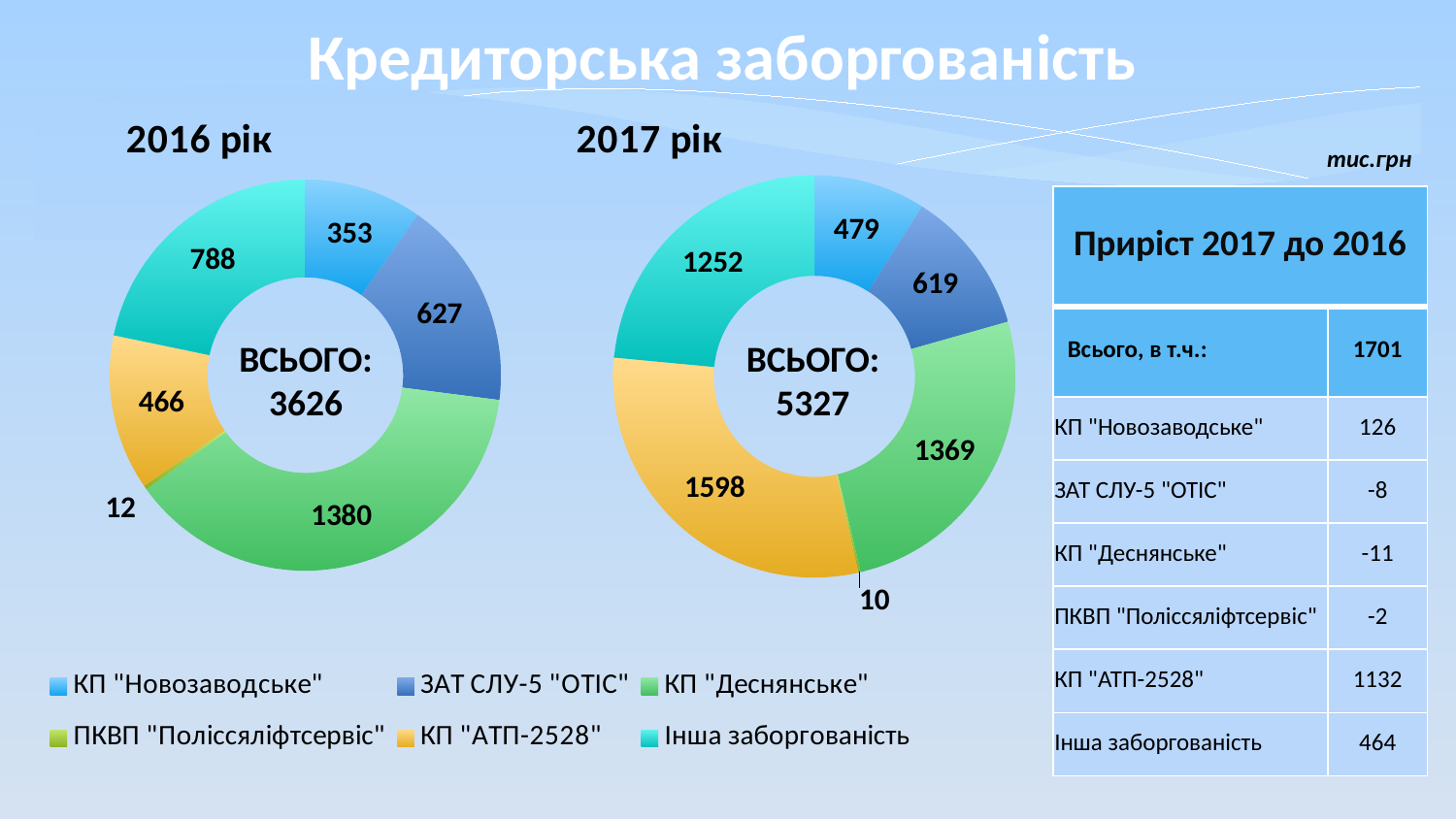
In the 2017 рік chart, what is the value for Інша заборгованість? 1252 How many categories does the legend list for the charts? 6 In the 2017 рік chart, which is larger: КП "АТП-2528" or КП "Деснянське"? КП "АТП-2528" In the 2017 рік chart, what is the value for КП "АТП-2528"? 1598 In the 2017 рік chart, which category has the smallest value? ПКВП "Поліссяліфтсервіс" In the 2016 рік chart, which category has the largest value? КП "Деснянське" What is the difference between the value for КП "АТП-2528" in the 2017 рік chart and in the 2016 рік chart? 1132 In the 2016 рік chart, what is the value for ЗАТ СЛУ-5 "ОТІС"? 627 What is the total (ВСЬОГО) shown in the 2017 рік chart? 5327 In the 2016 рік chart, what is the value for КП "Деснянське"? 1380 What type of chart is used for the 2016 рік and 2017 рік data? Doughnut (pie) chart What is the title of the slide containing the charts? Кредиторська заборгованість